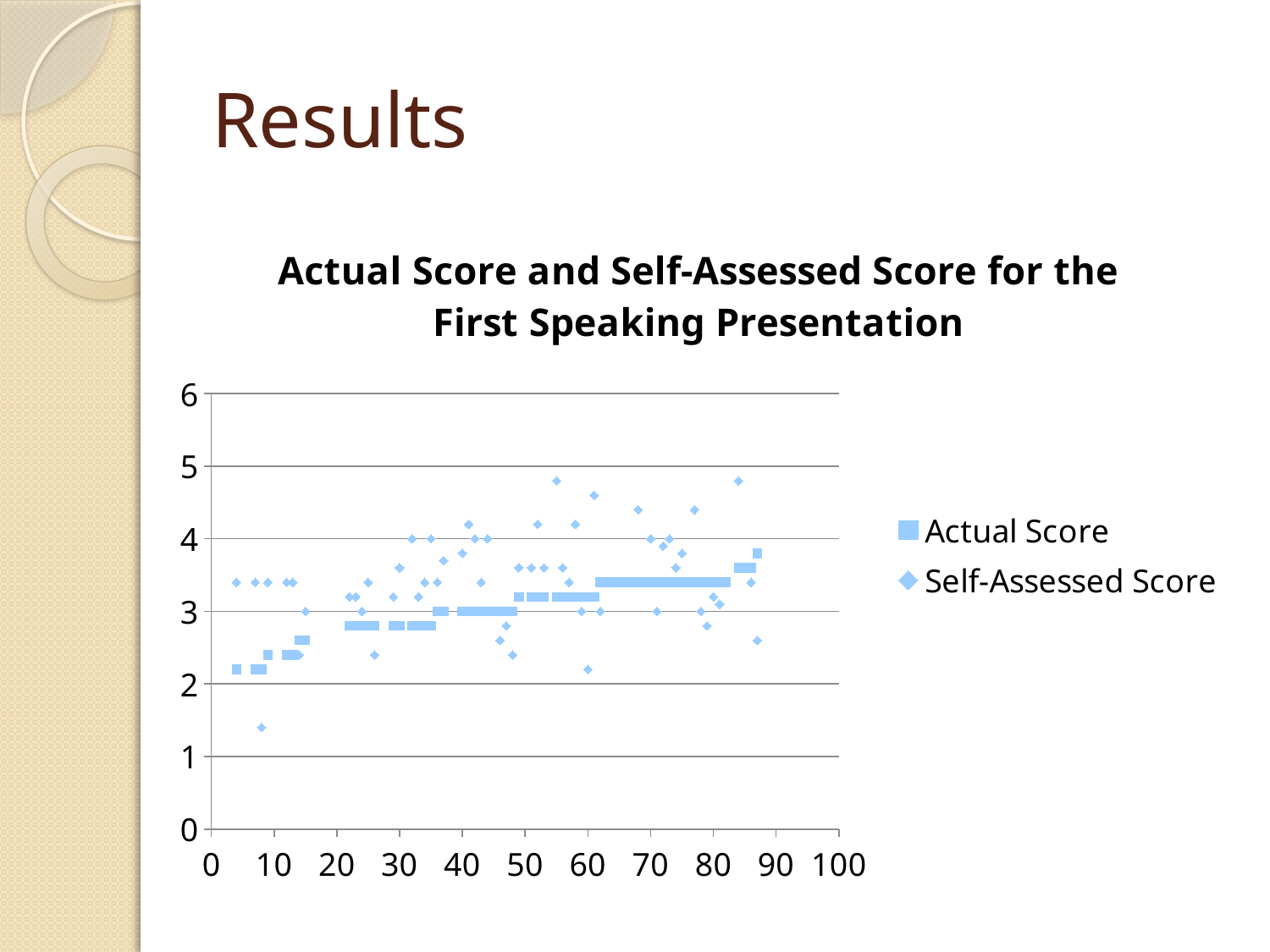
What is the title of the chart? Actual Score and Self-Assessed Score for the First Speaking Presentation Is the highest Self-Assessed Score value greater or less than 4? greater Is the highest Actual Score value greater or less than 5? less Is the lowest Self-Assessed Score value greater or less than 2? less What kind of chart is shown on the slide? Scatter chart Which series contains the single lowest plotted point, Actual Score or Self-Assessed Score? Self-Assessed Score How many series does the legend list? 2 Do the Actual Score values rise or fall as you move from left to right along the x axis? Rise Which series contains the single highest plotted point, Actual Score or Self-Assessed Score? Self-Assessed Score Which series is plotted with diamond markers? Self-Assessed Score